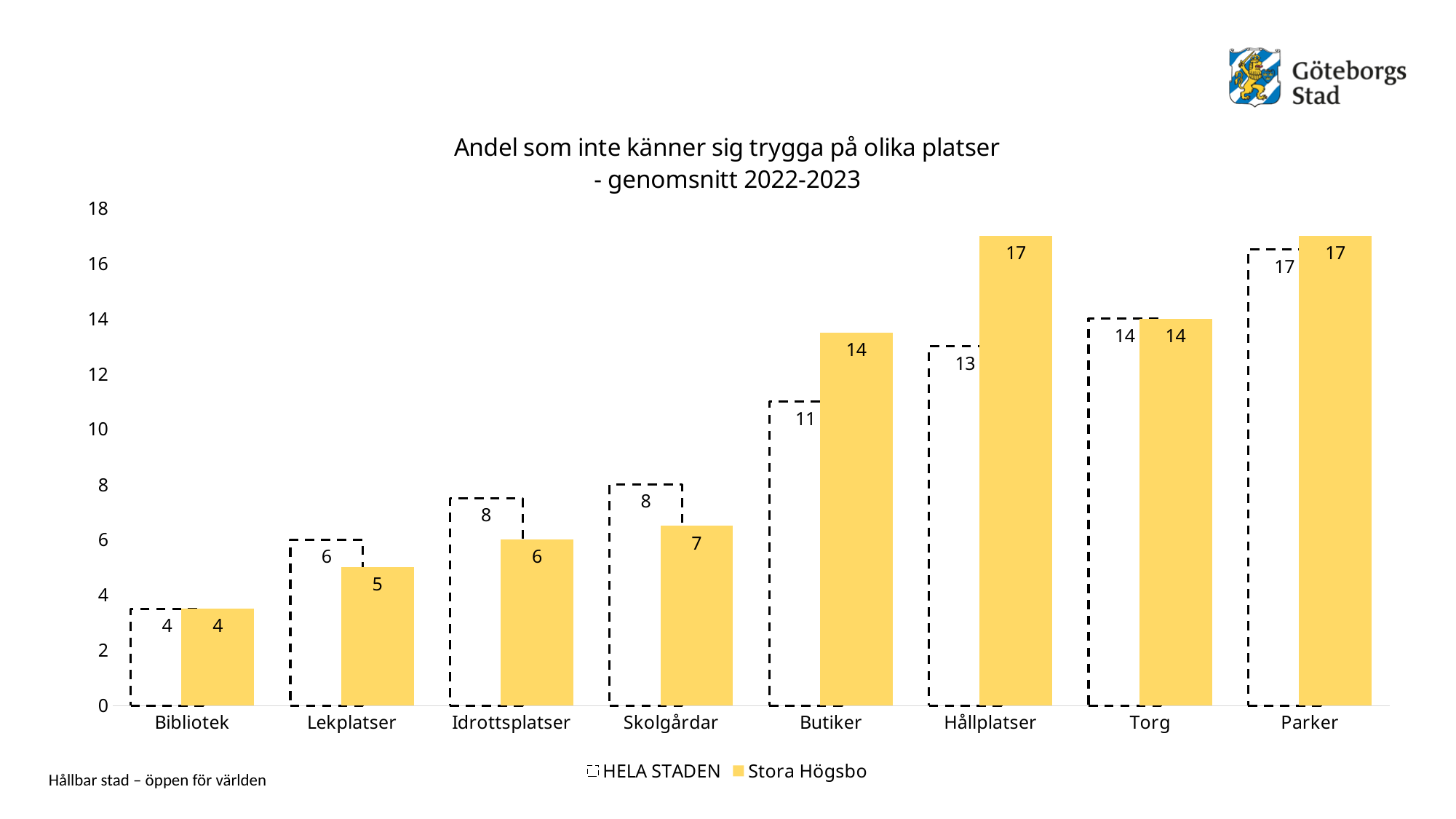
What is the difference between the Stora Högsbo and HELA STADEN values at Hållplatser? 4 At Butiker, which is larger: the value for Stora Högsbo or for HELA STADEN? Stora Högsbo Is the value for Stora Högsbo at Butiker greater or less than 12? greater Which category has the lowest value for Stora Högsbo? Bibliotek How many series does the legend list? 2 What is the value for HELA STADEN at Butiker? 11 What is the value for Stora Högsbo at Hållplatser? 17 What kind of chart is shown on the slide? bar chart Do the HELA STADEN values generally rise or fall from Bibliotek to Parker? rise How many categories are shown on the x axis? 8 What is the value for Stora Högsbo at Skolgårdar? 7 Which category has the highest value for HELA STADEN? Parker